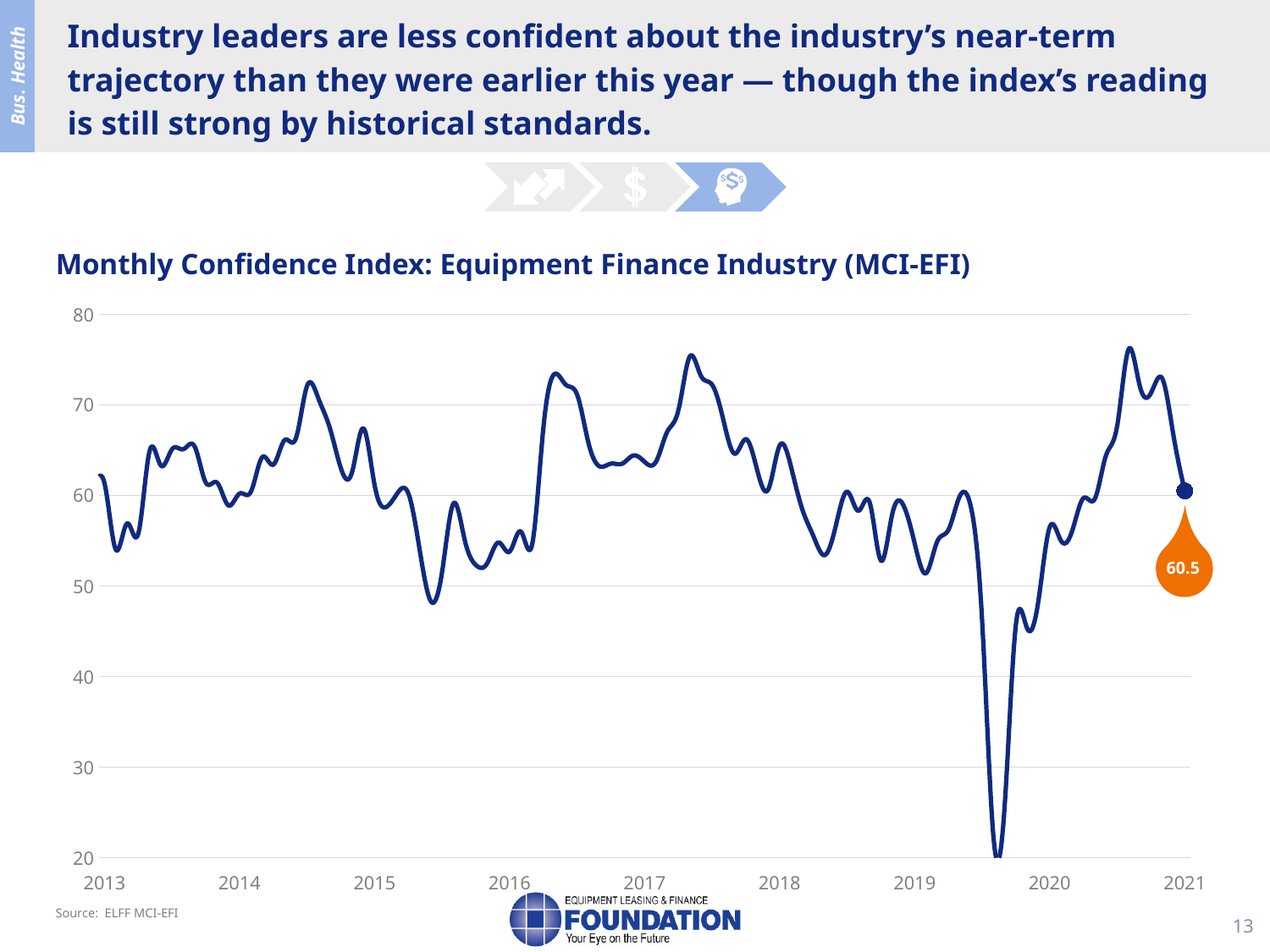
Is the final labelled value of 60.5 greater or less than 50? greater From the peak in 2020 to the final point in 2021, does the line rise or fall? Fall Is the lowest point of the line greater or less than 30? less Is the highest point of the line greater or less than 70? greater What is the range of the y axis? 20 to 80 What is the value of the final data point labelled on the chart? 60.5 What source is cited for the chart? ELFF MCI-EFI How many year labels are shown on the x axis? 9 What kind of chart is shown on the slide? Line chart What is the title of the chart? Monthly Confidence Index: Equipment Finance Industry (MCI-EFI)